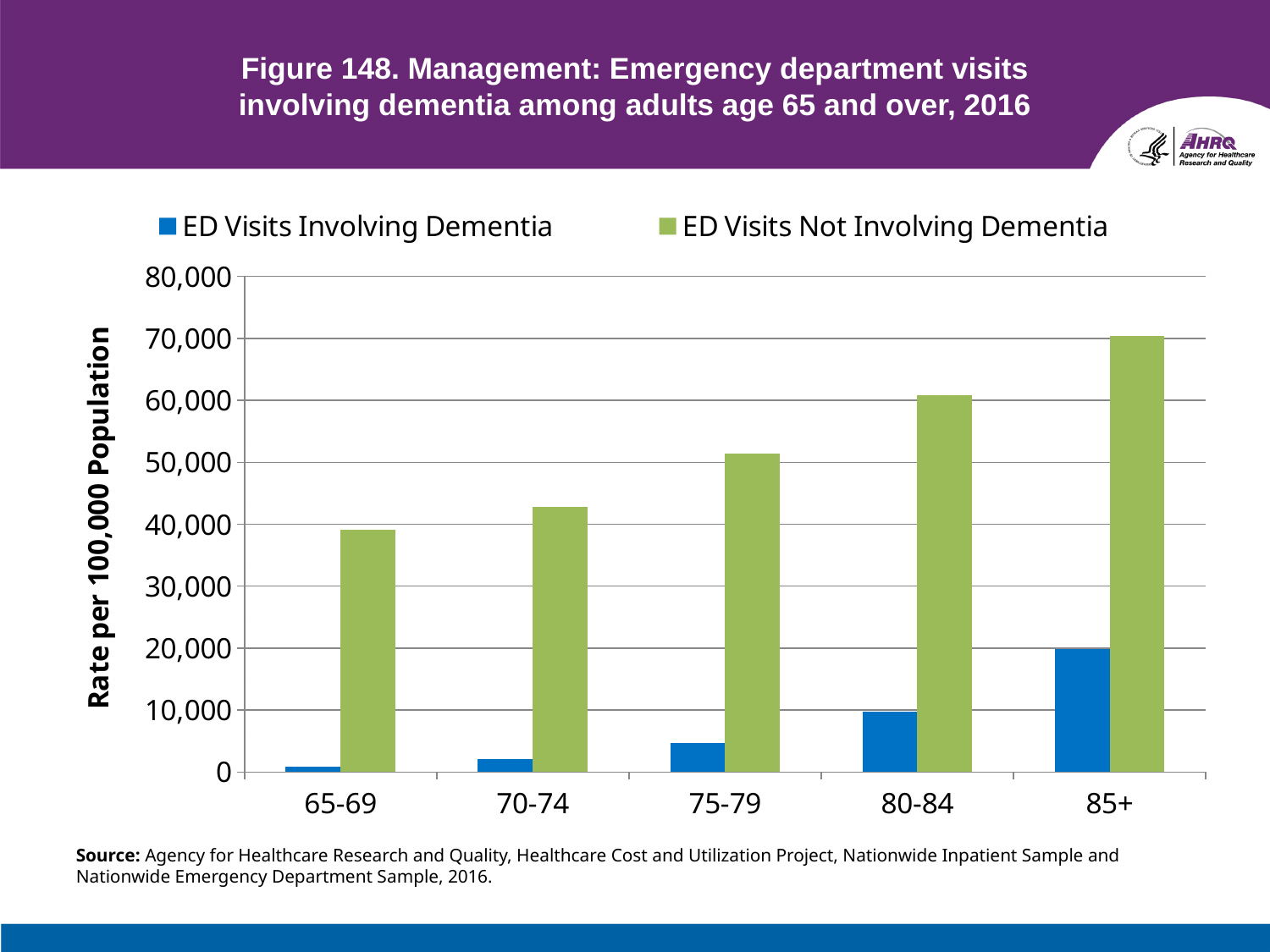
How many series does the legend list? 2 What kind of chart is shown on the slide? bar chart Is the rate of ED Visits Involving Dementia for the 70-74 group greater or less than 10,000? less Which age group has the highest rate of ED Visits Not Involving Dementia? 85+ Which is larger for the 80-84 group: ED Visits Involving Dementia or ED Visits Not Involving Dementia? ED Visits Not Involving Dementia Which age group has the lowest rate of ED Visits Involving Dementia? 65-69 Is the rate of ED Visits Not Involving Dementia for the 85+ group greater or less than 60,000? greater Is the rate of ED Visits Involving Dementia for the 85+ group greater or less than 10,000? greater What is the label of the y axis? Rate per 100,000 Population How many age groups are shown on the x axis? 5 Do the rates of ED Visits Involving Dementia rise or fall as age group increases along the x axis? rise